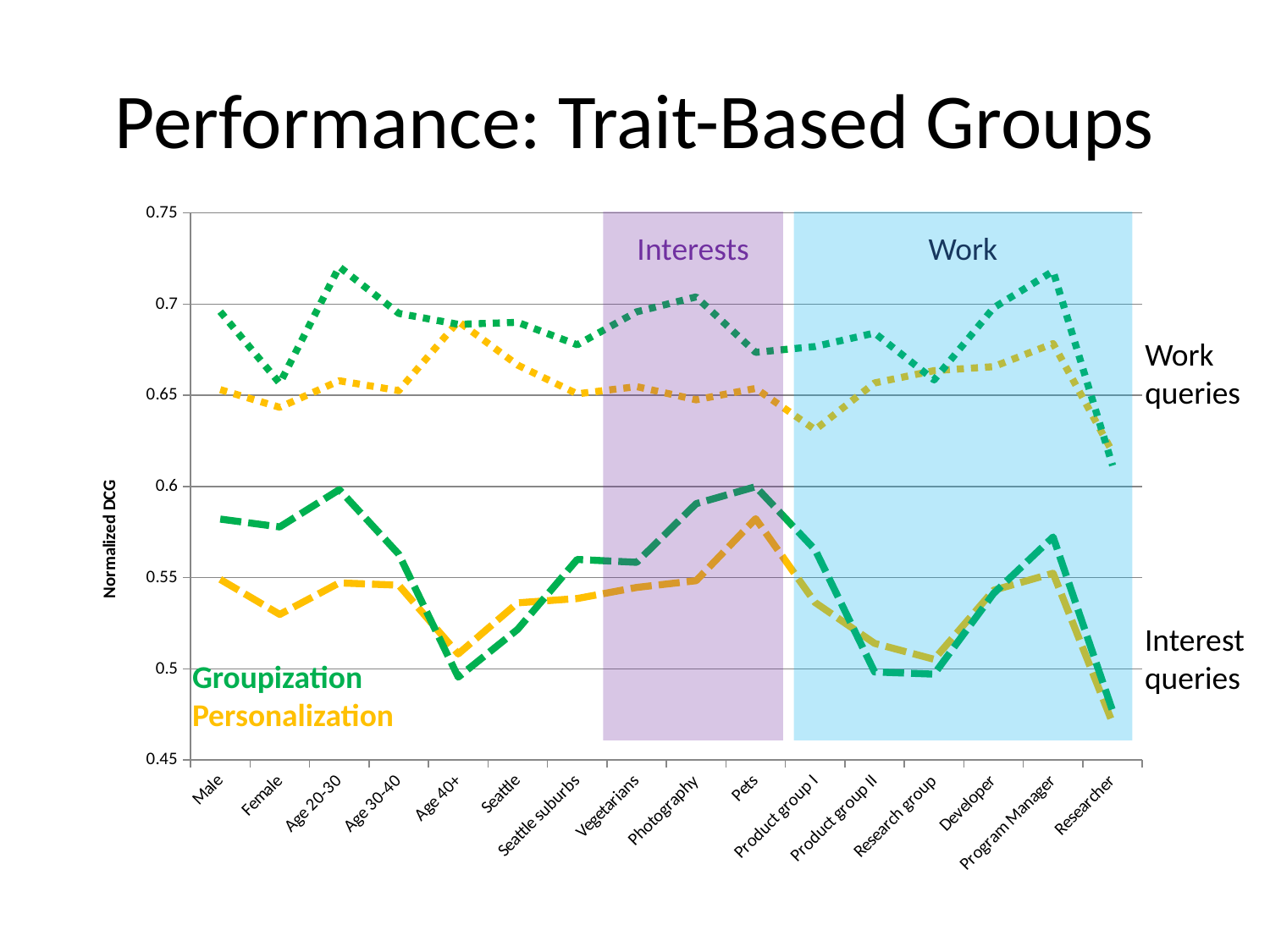
For Work queries, which group has the lowest Groupization value? Researcher For Work queries at Male, which is higher: Groupization or Personalization? Groupization Is the Personalization value for Work queries at Product group I greater or less than 0.65? less Is the Personalization value for Interest queries at Pets greater or less than 0.55? greater What is the label on the y axis of the chart? Normalized DCG How many groups are listed along the x axis of the chart? 16 Do the Interest queries lines rise or fall from Program Manager to Researcher? fall What kind of chart is shown on the slide? line chart Is the Groupization value for Work queries at Age 20-30 greater or less than 0.7? greater For Interest queries, which group has the highest Personalization value? Pets Which colour represents Groupization in the chart? green